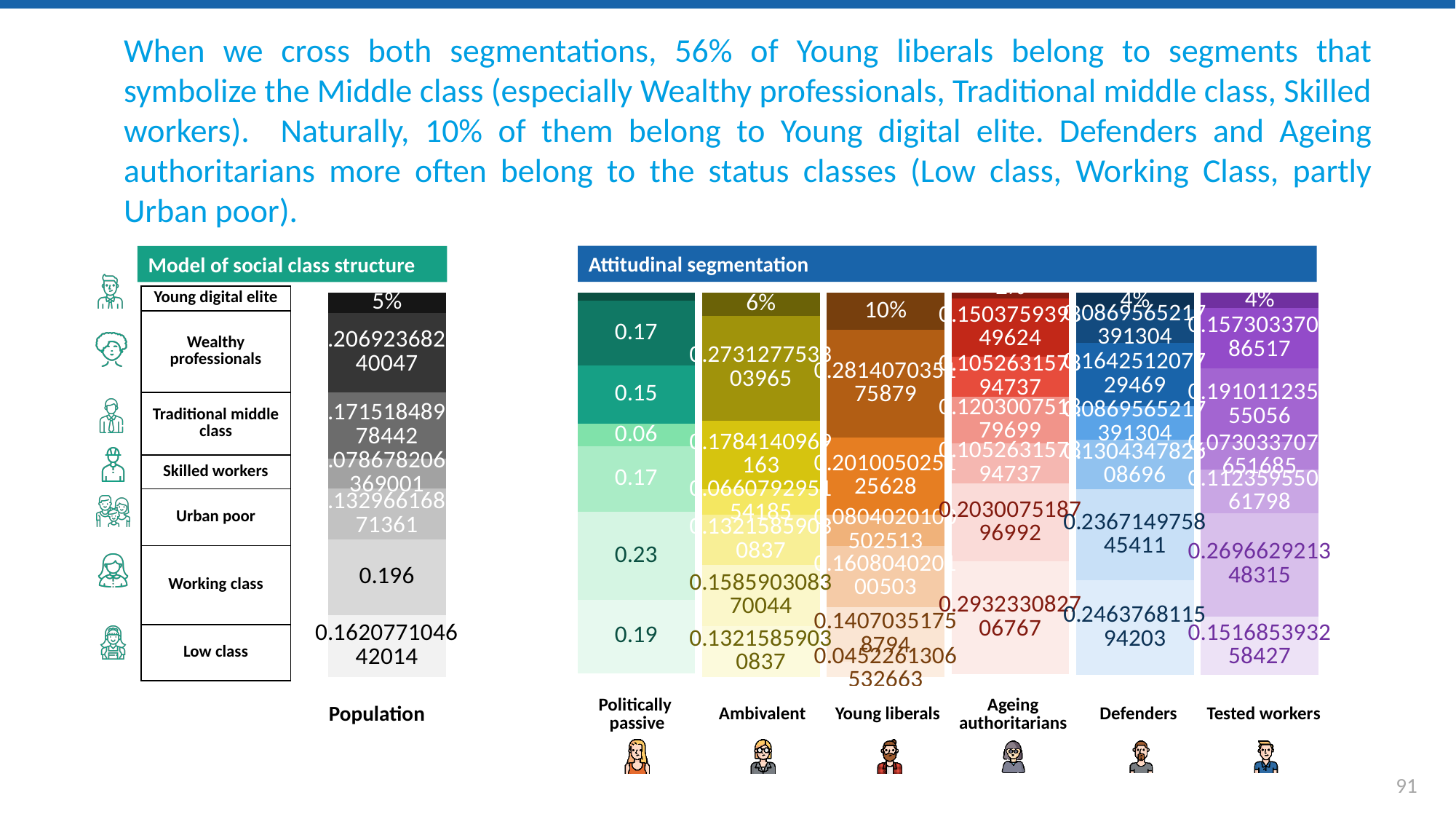
In the Attitudinal segmentation chart, what is the value for Working class in the Politically passive bar? 0.23 In the Population chart, what is the value for Young digital elite? 5% In the Attitudinal segmentation chart, which has a larger Low class share: Ageing authoritarians or Young liberals? Ageing authoritarians How many attitudinal segments are shown in the Attitudinal segmentation chart? 6 In the Attitudinal segmentation chart, what is the value for Skilled workers in the Politically passive bar? 0.06 In the Attitudinal segmentation chart, what is the difference between the Working class and Low class values in the Politically passive bar? 0.04 In the Attitudinal segmentation chart, which social class has the smallest share within the Politically passive bar? Young digital elite In the Attitudinal segmentation chart, what share of Ambivalent belongs to Young digital elite? 6% In the Attitudinal segmentation chart, what share of Young liberals belongs to Young digital elite? 10% In the Population chart, what is the value for Working class? 0.196 What kind of chart is the Attitudinal segmentation chart? Stacked bar chart In the Attitudinal segmentation chart, which social class has the largest share within the Politically passive bar? Working class